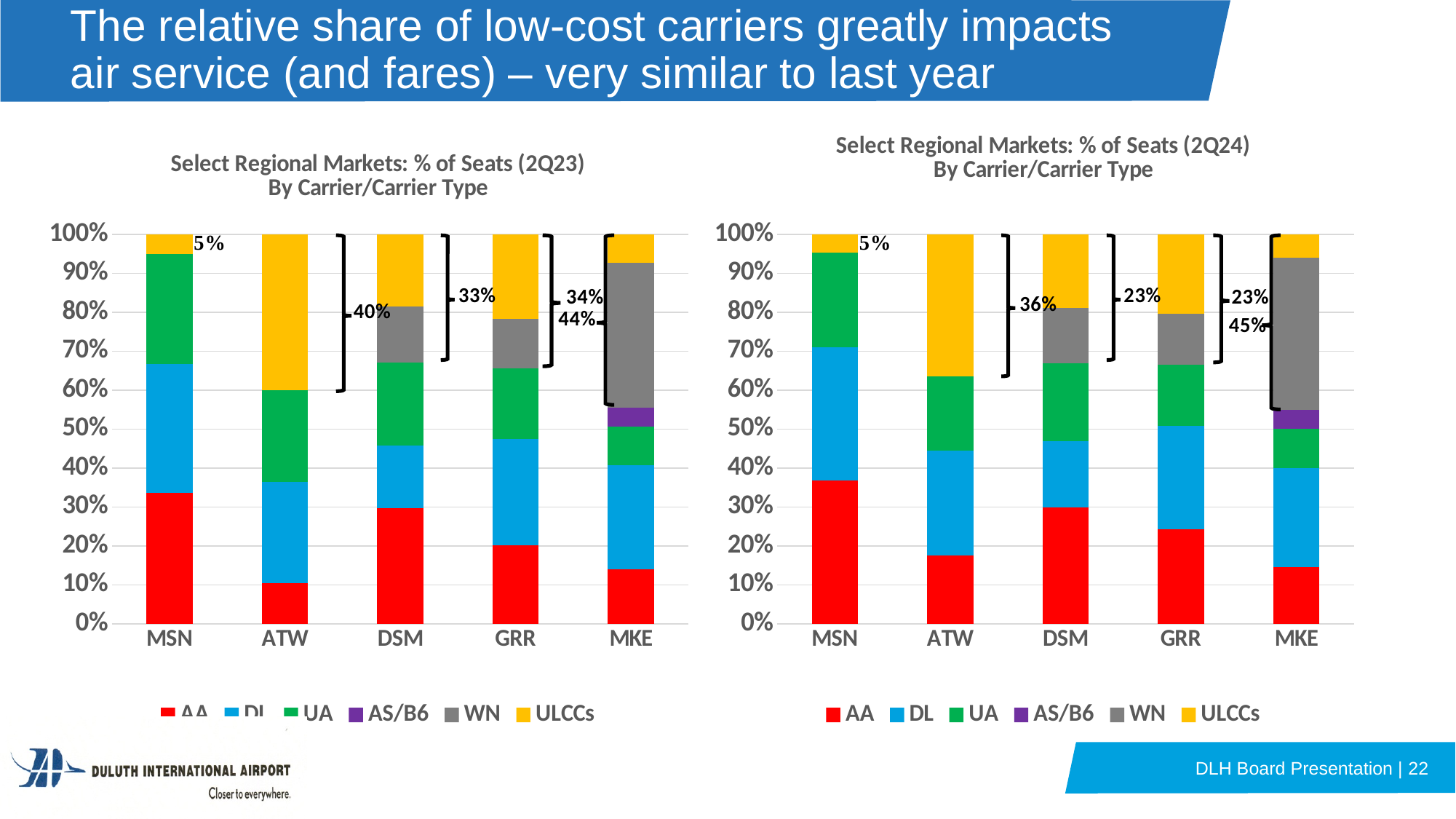
In the 2Q23 chart, what percentage is annotated for GRR? 34% What type of chart is the 2Q24 chart? Stacked bar chart In the 2Q24 chart, what low-cost carrier share is annotated for ATW? 36% In the 2Q23 chart, which market has the lowest annotated percentage? MSN In the 2Q24 chart, what percentage is annotated for DSM? 23% Is the annotated percentage for ATW larger in the 2Q23 chart or the 2Q24 chart? 2Q23 How many markets are shown on the x axis of the 2Q23 chart? 5 How many series does the legend of the 2Q24 chart list? 6 In the 2Q23 chart, what low-cost carrier share is annotated for MKE? 44% In the 2Q24 chart, which market has the highest annotated low-cost carrier share? MKE What is the difference between the annotated percentages for DSM in the 2Q23 chart and the 2Q24 chart? 10% In the 2Q24 chart, is the AA share for MSN greater or less than 30%? greater